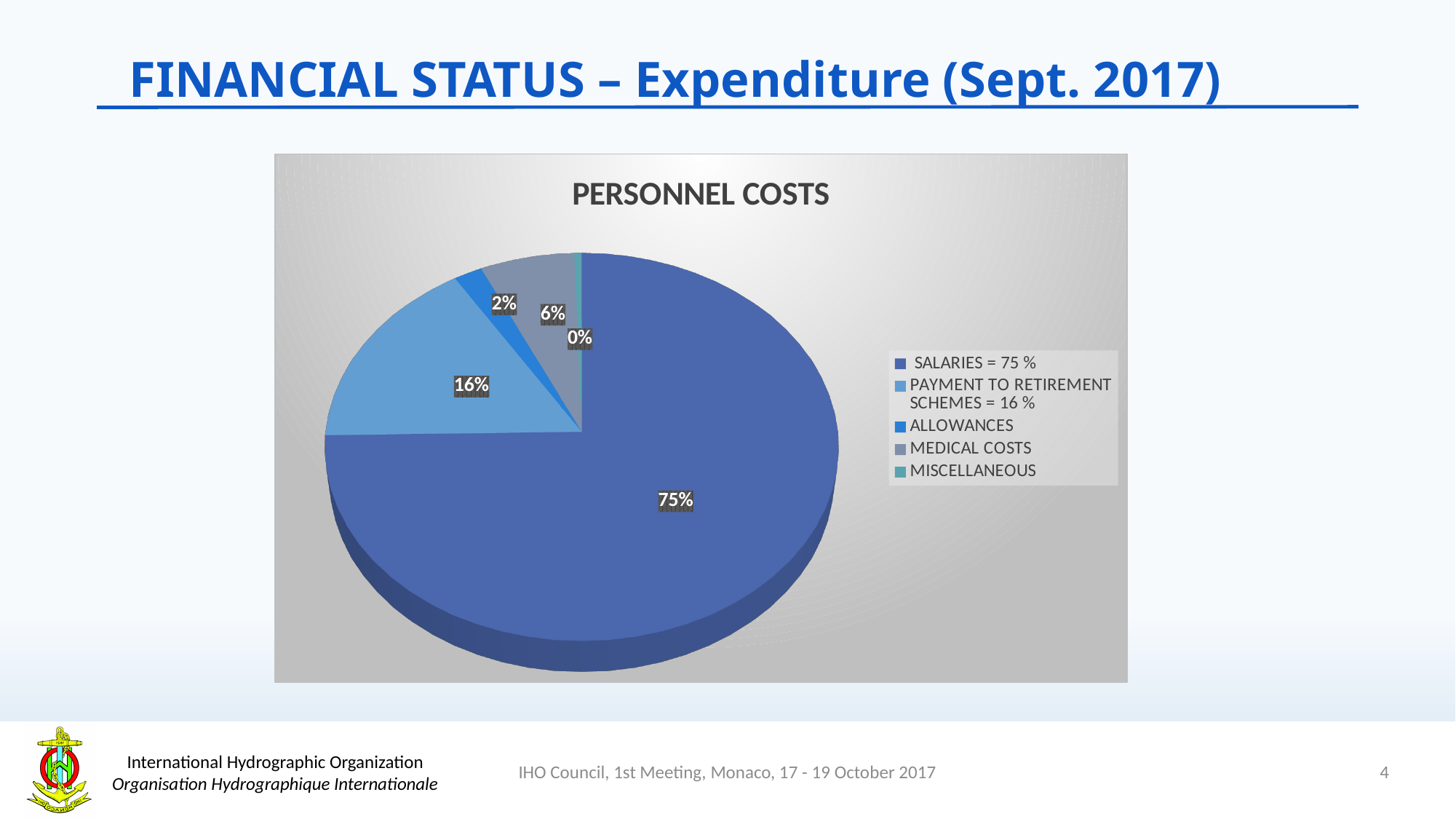
What share of personnel costs is Salaries? 75% What kind of chart is shown on the slide? Pie chart Which is larger, the Medical Costs share or the Allowances share? Medical Costs How many categories does the legend list? 5 Which category has the largest share of personnel costs? Salaries What share of personnel costs is Miscellaneous? 0% What is the difference in percentage points between the Salaries share and the Payment to Retirement Schemes share? 59 What share of personnel costs is Payment to Retirement Schemes? 16% What is the title of the chart? PERSONNEL COSTS Which category has the smallest share of personnel costs? Miscellaneous